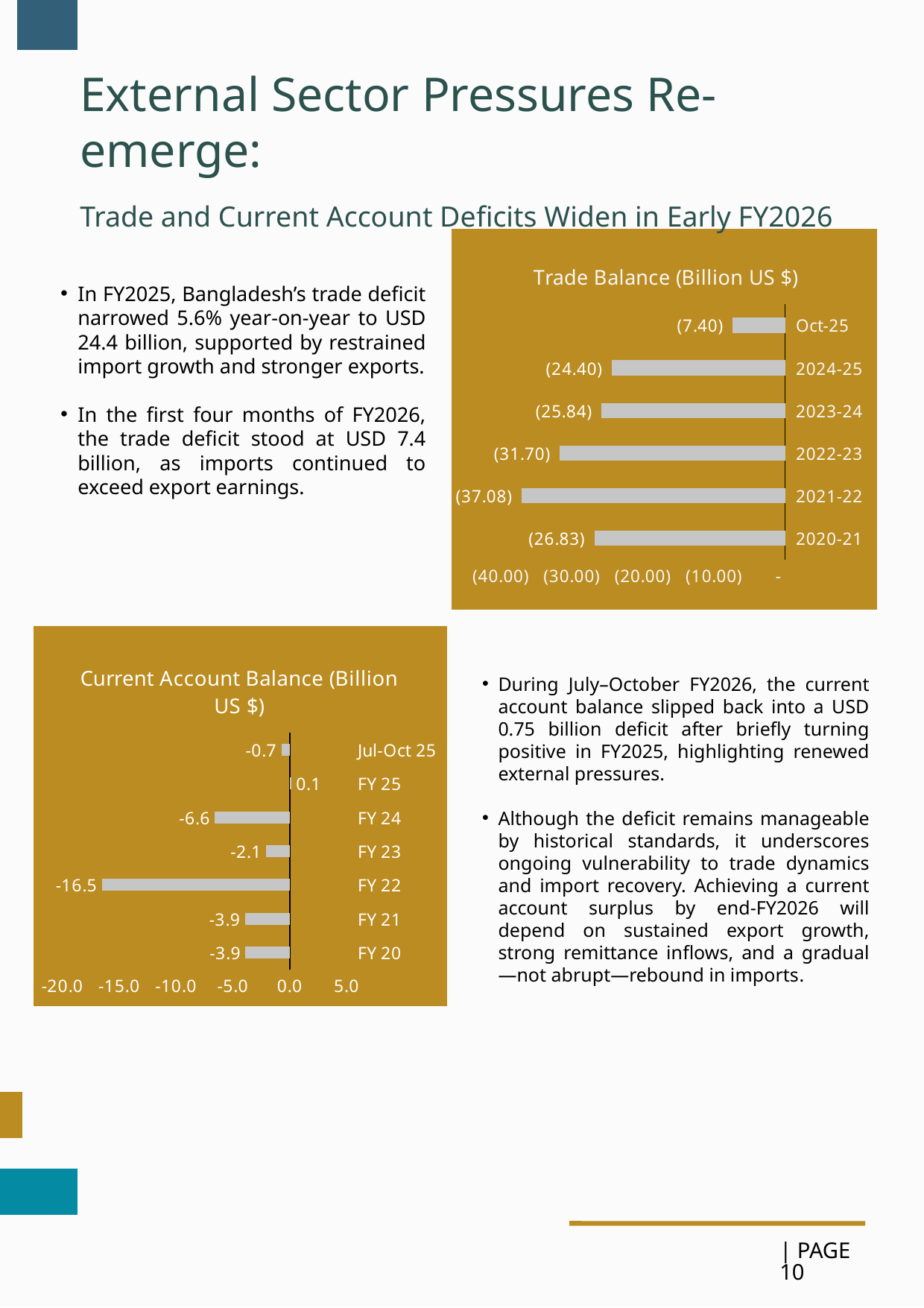
In the Current Account Balance (Billion US $) chart, which period has the highest value? FY 25 In the Current Account Balance (Billion US $) chart, which is larger, the value for FY 24 or the value for FY 23? FY 23 In the Current Account Balance (Billion US $) chart, what is the value for FY 22? -16.5 In the Current Account Balance (Billion US $) chart, what is the value for Jul-Oct 25? -0.7 In the Trade Balance (Billion US $) chart, what is the value for Oct-25? (7.40) In the Trade Balance (Billion US $) chart, what is the value for 2021-22? (37.08) What type of chart is the Trade Balance (Billion US $) chart? Bar chart In the Trade Balance (Billion US $) chart, how many periods are shown? 6 In the Current Account Balance (Billion US $) chart, how many periods are shown? 7 In the Current Account Balance (Billion US $) chart, which period has the lowest value? FY 22 In the Trade Balance (Billion US $) chart, which period has the largest trade deficit? 2021-22 In the Trade Balance (Billion US $) chart, what is the difference between the 2023-24 and 2024-25 values? 1.44